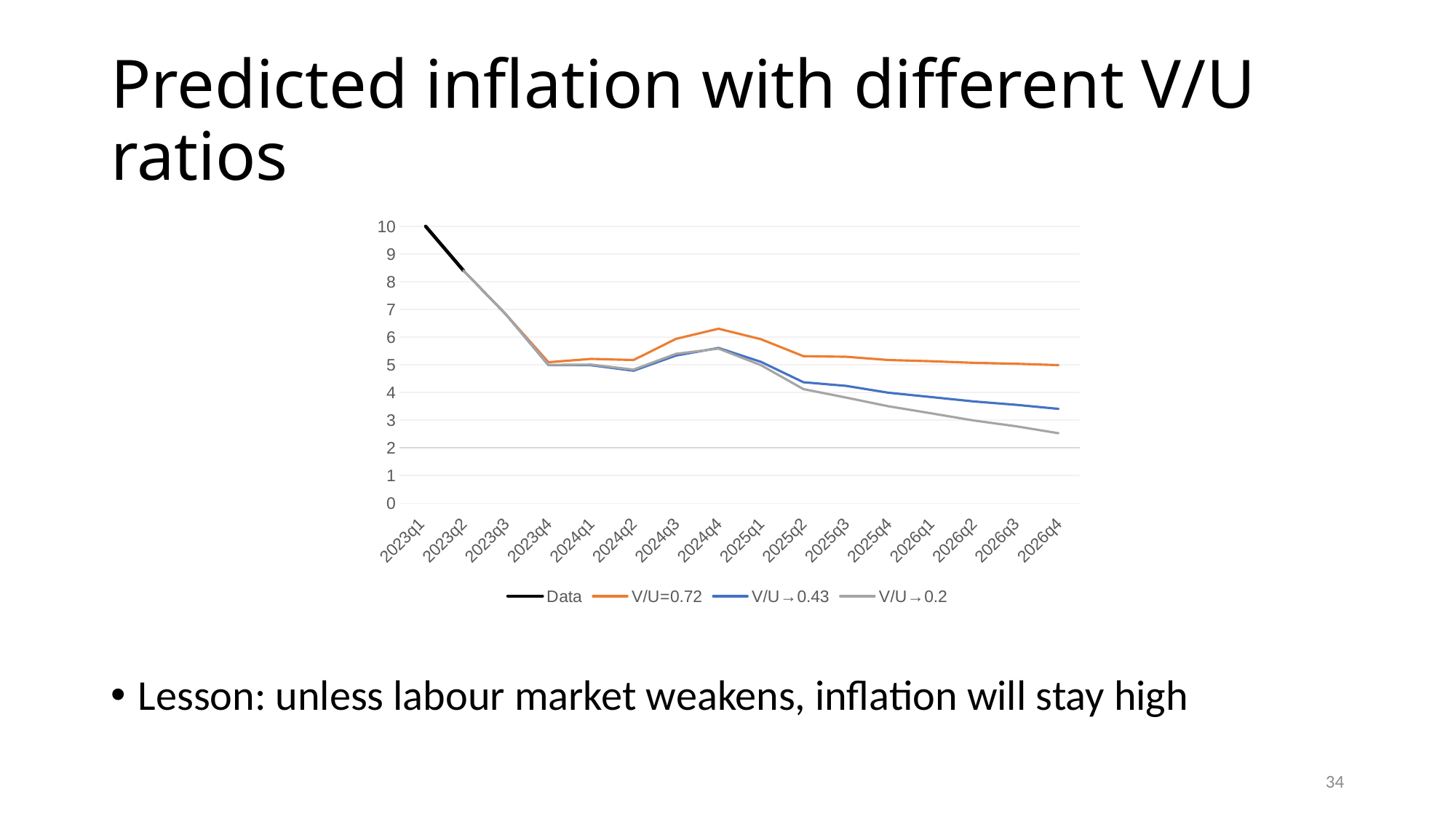
What kind of chart is shown on the slide? line chart What is the title of the slide containing the chart? Predicted inflation with different V/U ratios Is the value of the Data series at 2023q1 greater or less than 9? greater Which series has the lowest value at 2026q4? V/U→0.2 Which series has the highest value at 2026q4? V/U=0.72 Does the V/U→0.2 series rise or fall from 2024q4 to 2026q4? fall How many quarters are shown along the x axis? 16 At 2026q4, which series has the higher value: V/U=0.72 or V/U→0.2? V/U=0.72 Is the value of the V/U=0.72 series at 2026q4 greater or less than 4? greater How many series does the legend list? 4 Is the value of the V/U→0.2 series at 2026q4 greater or less than 3? less